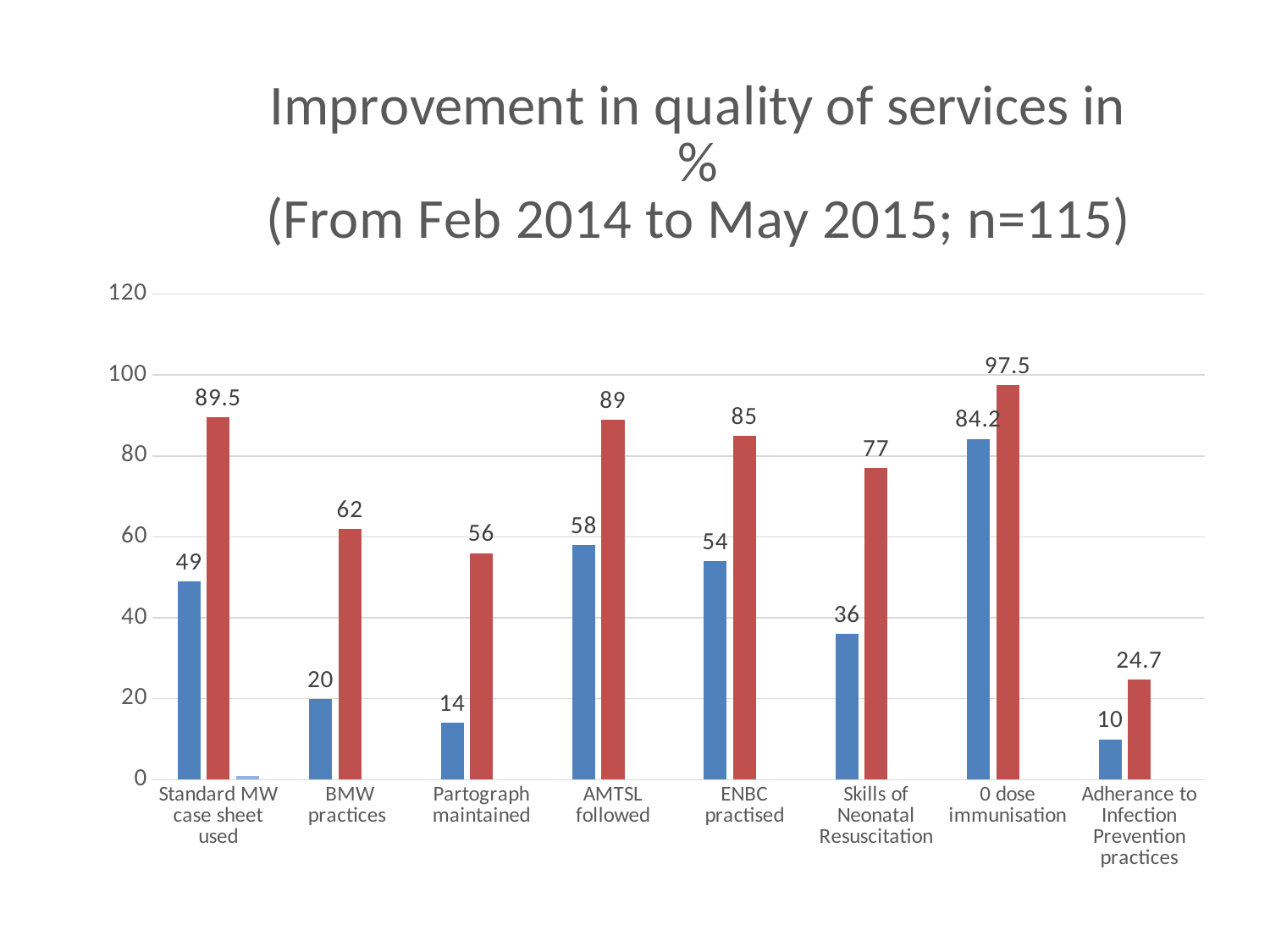
What is the title of the chart? Improvement in quality of services in % (From Feb 2014 to May 2015; n=115) Which is larger, the red bar for AMTSL followed or the red bar for ENBC practised? AMTSL followed What kind of chart is shown on the slide? Bar chart How many categories are shown on the x axis? 8 Which category has the highest red bar? 0 dose immunisation What is the value of the red bar for 0 dose immunisation? 97.5 What is the difference between the red and blue bars for Standard MW case sheet used? 40.5 What is the value of the blue bar for Skills of Neonatal Resuscitation? 36 Which category has the lowest blue bar? Adherance to Infection Prevention practices What is the difference between the red and blue bars for BMW practices? 42 What is the value of the red bar for Adherance to Infection Prevention practices? 24.7 What is the value of the blue bar for Partograph maintained? 14